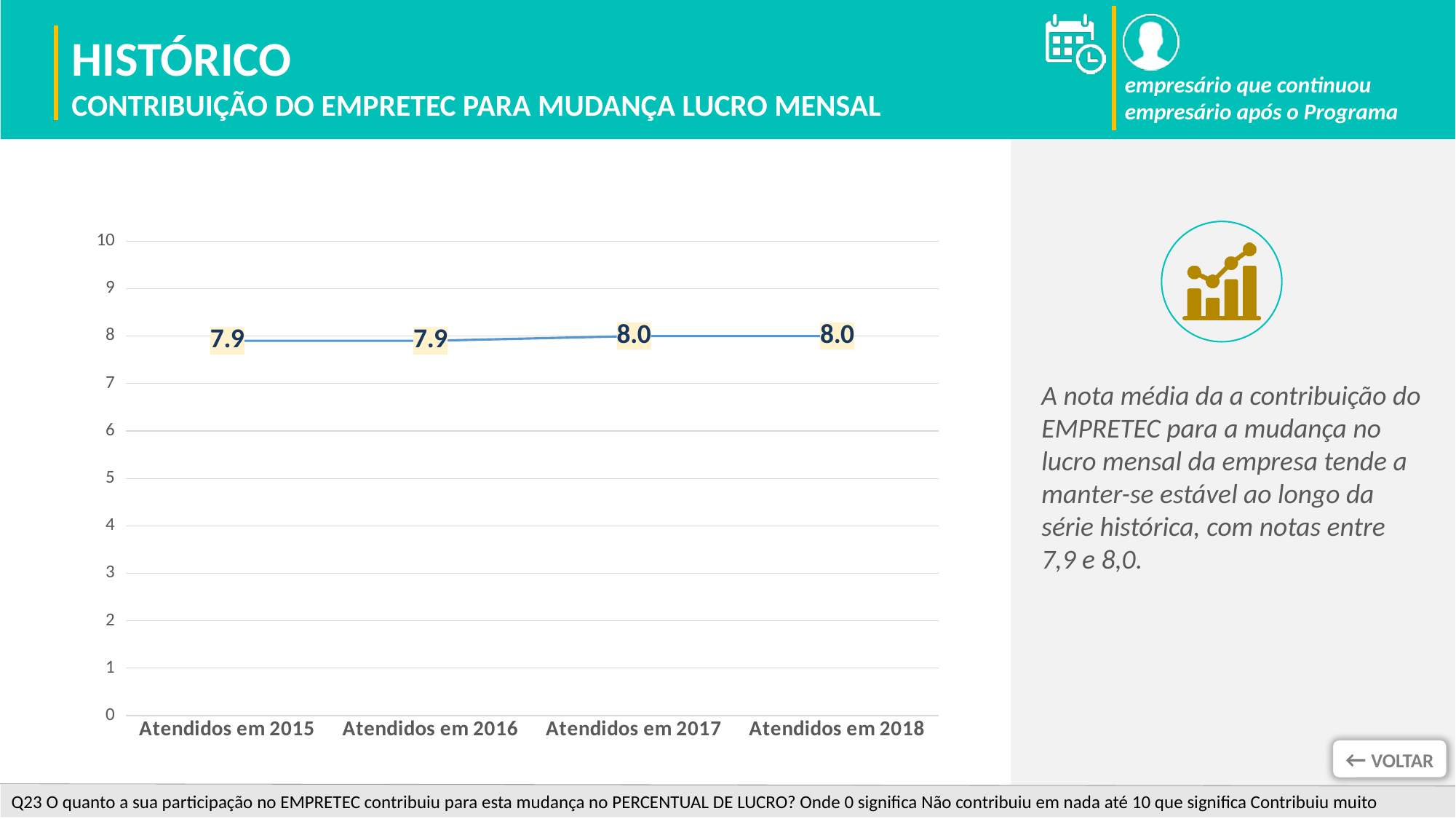
What is the difference between the values for Atendidos em 2017 and Atendidos em 2015? 0.1 What is the value for Atendidos em 2018? 8.0 What is the value for Atendidos em 2016? 7.9 Which is larger, the value for Atendidos em 2016 or the value for Atendidos em 2018? Atendidos em 2018 What is the subtitle of the slide above the chart? CONTRIBUIÇÃO DO EMPRETEC PARA MUDANÇA LUCRO MENSAL How many categories are shown on the x axis? 4 What is the highest value shown on the y axis? 10 Do the values rise, fall or stay roughly stable from Atendidos em 2015 to Atendidos em 2018? roughly stable, rising slightly from 7.9 to 8.0 Is the value for Atendidos em 2015 greater or less than 5? greater What kind of chart is shown on the slide? line chart What is the value for Atendidos em 2017? 8.0 What is the value for Atendidos em 2015? 7.9